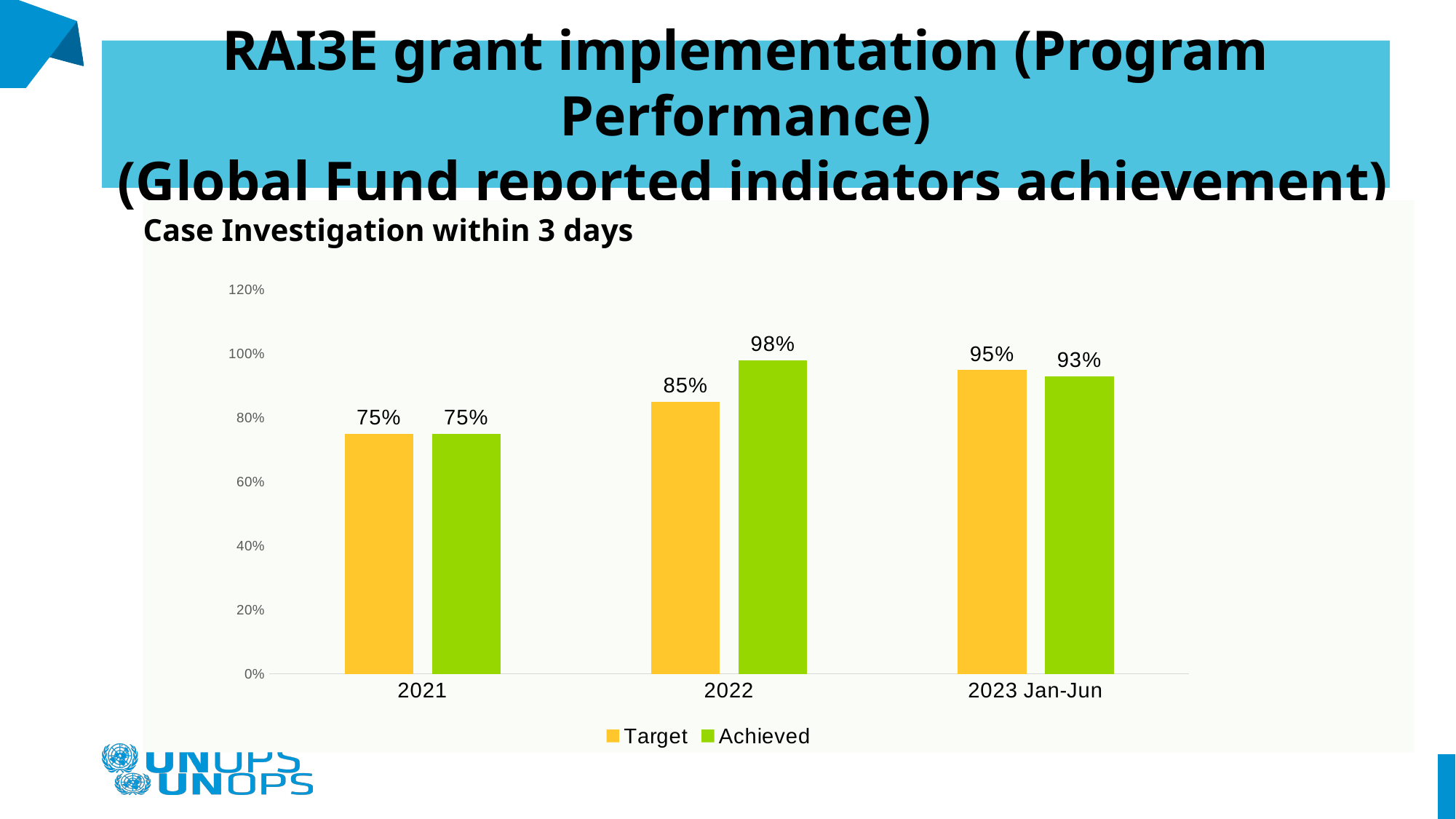
What is the Achieved value for 2022? 98% Is the Target value for 2023 Jan-Jun larger or smaller than the Achieved value for 2023 Jan-Jun? larger What is the difference between the Achieved and Target values for 2022? 13% How many periods are shown on the x axis? 3 What is the Achieved value for 2023 Jan-Jun? 93% What is the title of the chart? Case Investigation within 3 days Which period has the highest Achieved value? 2022 Which period has the lowest Target value? 2021 How many series does the legend list? 2 What is the Target value for 2021? 75% What is the Target value for 2023 Jan-Jun? 95% What kind of chart is shown? bar chart